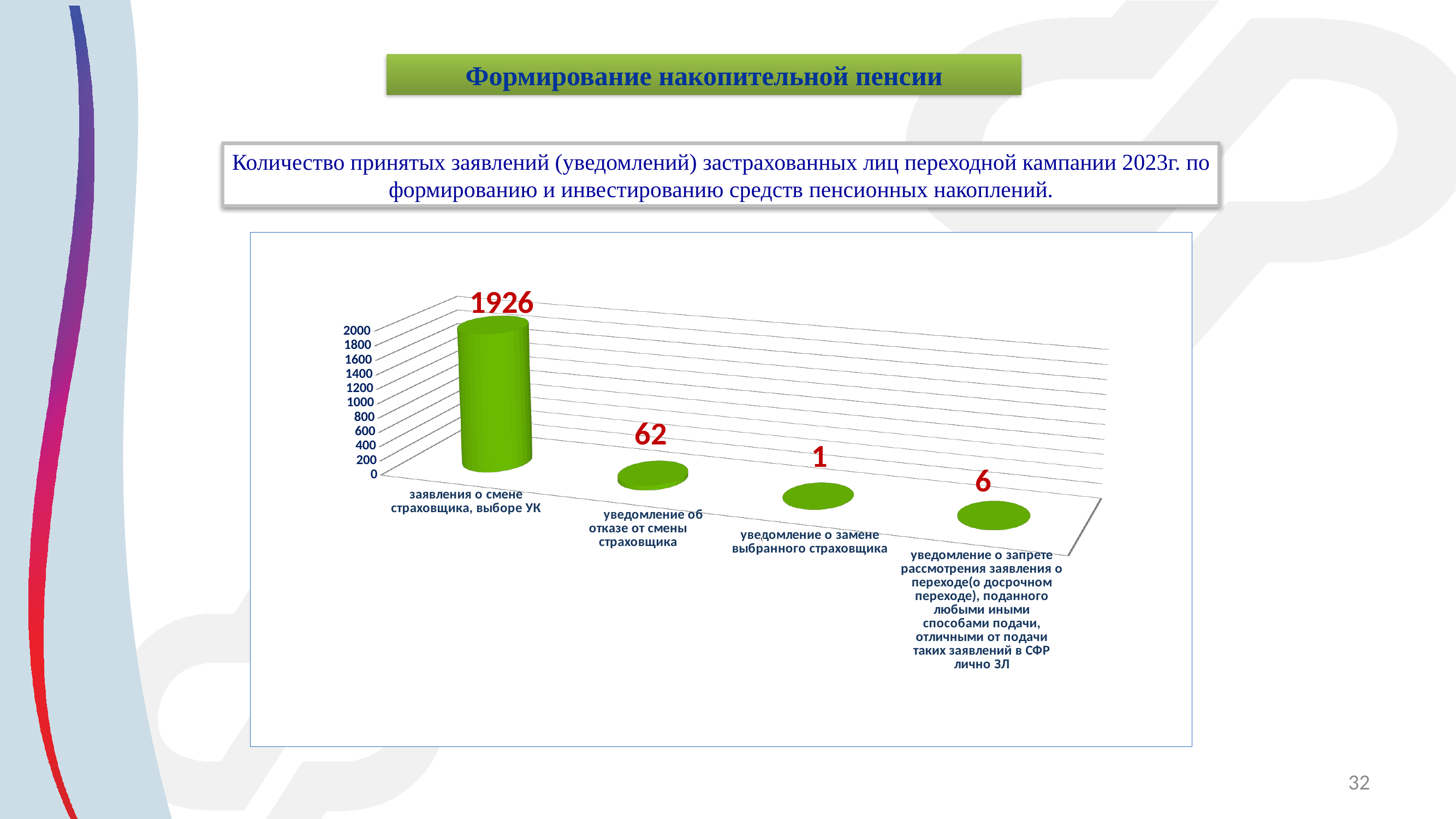
What is the value for the category "уведомление о запрете рассмотрения заявления о переходе..."? 6 Which is larger: the value for "уведомление об отказе от смены страховщика" or the value for "уведомление о запрете рассмотрения заявления о переходе..."? уведомление об отказе от смены страховщика Which category has the lowest value? уведомление о замене выбранного страховщика How many categories are shown in the chart? 4 What is the value for "заявления о смене страховщика, выборе УК"? 1926 Which category has the highest value? заявления о смене страховщика, выборе УК What is the value for "уведомление об отказе от смены страховщика"? 62 Is the value for "заявления о смене страховщика, выборе УК" greater or less than 1800? greater What is the value for "уведомление о замене выбранного страховщика"? 1 What kind of chart is shown on the slide? bar chart What colour are the bars in the chart? green What is the difference between the values for "заявления о смене страховщика, выборе УК" and "уведомление об отказе от смены страховщика"? 1864